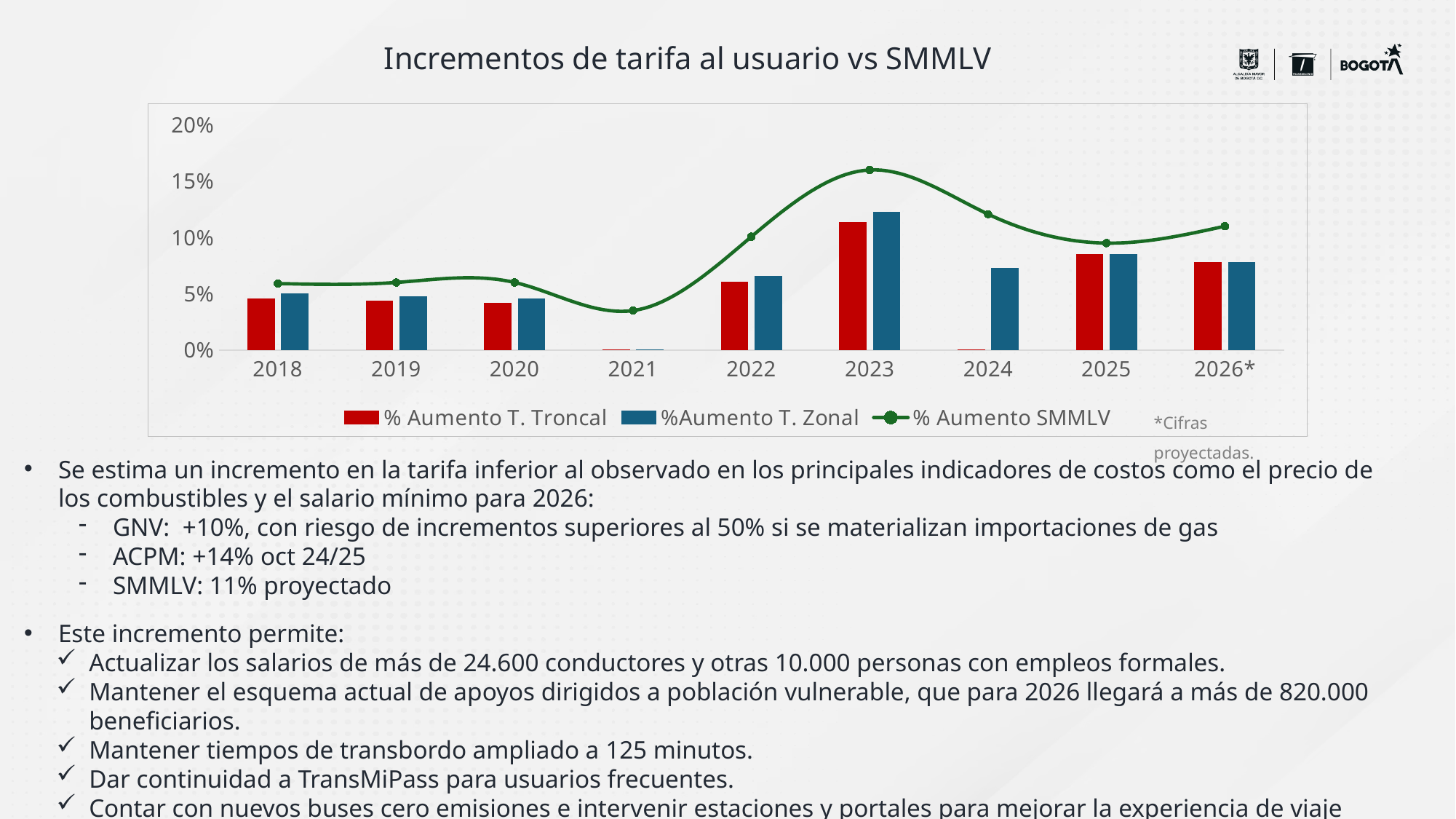
How many years are shown on the x axis of the chart? 9 Is the % Aumento SMMLV value for 2023 greater or less than 15%? greater In which year does the % Aumento SMMLV line reach its highest value? 2023 In 2024, which is larger: % Aumento T. Troncal or %Aumento T. Zonal? %Aumento T. Zonal In which year is the % Aumento T. Troncal bar the tallest? 2023 In which year does the % Aumento SMMLV line reach its lowest value? 2021 Is the %Aumento T. Zonal value for 2024 greater or less than 5%? greater Which series in the chart is drawn as a green line with markers? % Aumento SMMLV How many series does the chart legend list? 3 Does the % Aumento SMMLV line rise or fall from 2021 to 2023? Rise What kind of chart is shown on the slide? A combined bar and line chart Is the % Aumento T. Troncal value for 2023 greater or less than 10%? greater